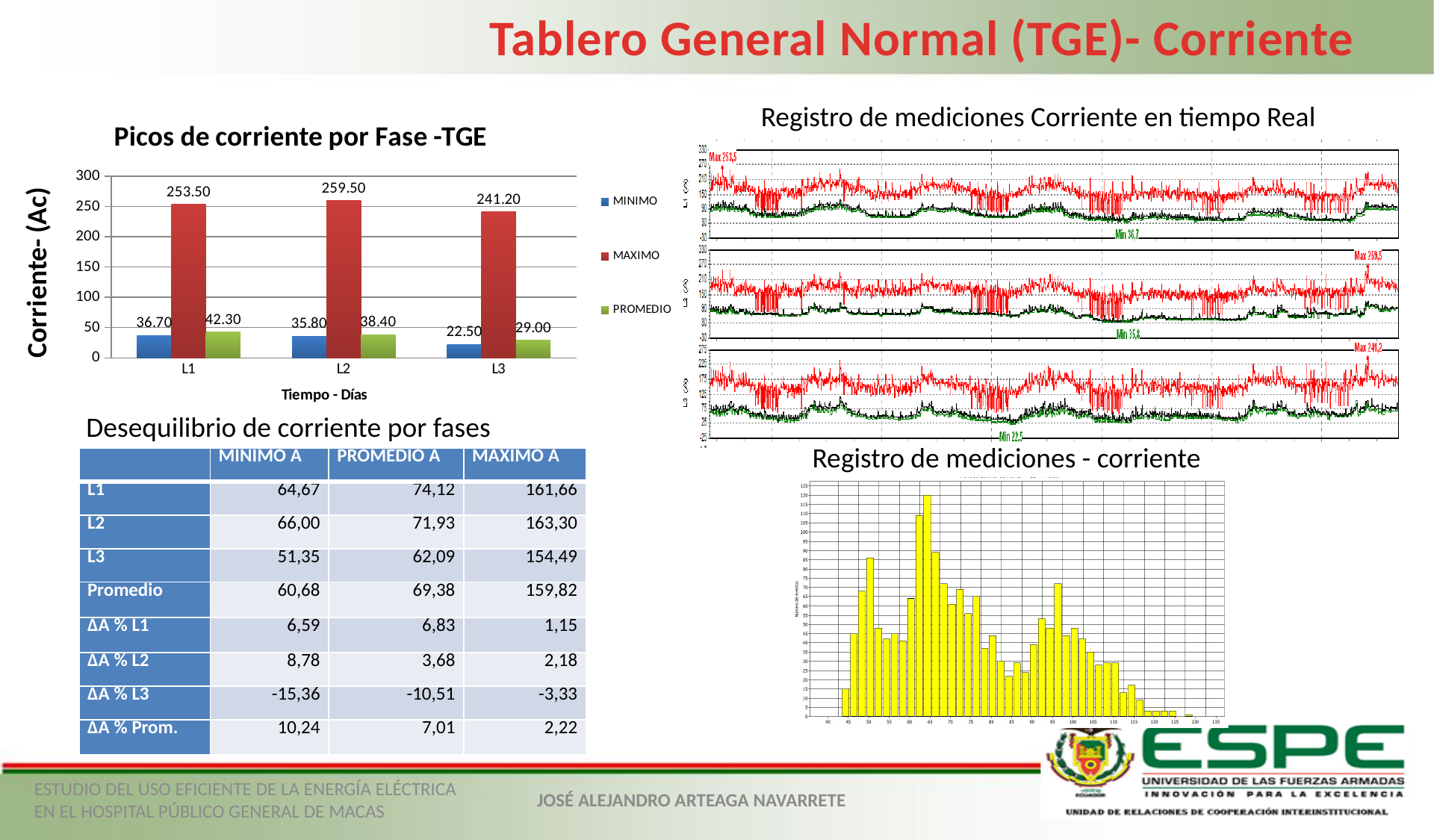
In the chart 'Picos de corriente por Fase -TGE', what is the MINIMO value for L3? 22.50 In the chart 'Picos de corriente por Fase -TGE', which is larger: the MINIMO value for L1 or the MINIMO value for L3? L1 How many categories are shown on the x axis of the chart 'Picos de corriente por Fase -TGE'? 3 In the chart 'Picos de corriente por Fase -TGE', what is the difference between the MAXIMO values of L2 and L3? 18.30 In the chart 'Picos de corriente por Fase -TGE', what is the label of the y axis? Corriente- (Ac) What kind of chart is 'Picos de corriente por Fase -TGE'? Bar chart In the chart 'Picos de corriente por Fase -TGE', which phase has the lowest PROMEDIO value? L3 In the chart 'Picos de corriente por Fase -TGE', is the MAXIMO value for L3 greater or less than 200? greater In the chart 'Picos de corriente por Fase -TGE', what is the PROMEDIO value for L1? 42.30 How many series does the legend of the chart 'Picos de corriente por Fase -TGE' list? 3 In the chart 'Picos de corriente por Fase -TGE', what is the MAXIMO value for L2? 259.50 In the chart 'Picos de corriente por Fase -TGE', which phase has the highest MAXIMO value? L2